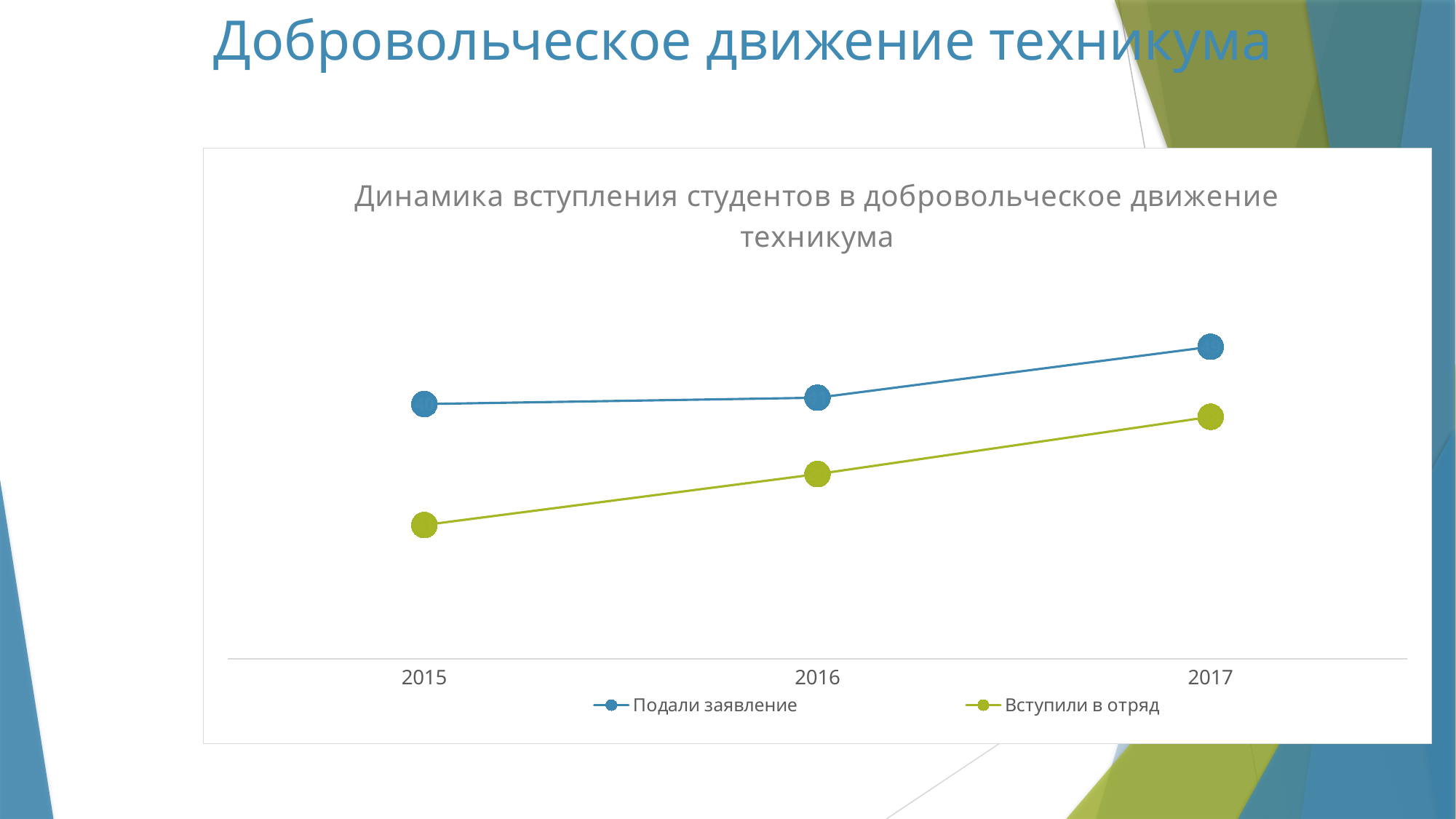
In which year is the 'Вступили в отряд' series lowest? 2015 What is the title of the chart? Динамика вступления студентов в добровольческое движение техникума In 2017, which series has the larger value: 'Подали заявление' or 'Вступили в отряд'? Подали заявление What kind of chart is shown on the slide? line chart In which year is the 'Подали заявление' series highest? 2017 Does the 'Вступили в отряд' series rise or fall from 2015 to 2017? rise How many series does the chart legend list? 2 In which year is the 'Вступили в отряд' series highest? 2017 In 2015, which series has the larger value: 'Подали заявление' or 'Вступили в отряд'? Подали заявление How many years are shown on the x axis of the chart? 3 Does the 'Подали заявление' series rise or fall from 2016 to 2017? rise Which series is drawn in green in the chart? Вступили в отряд